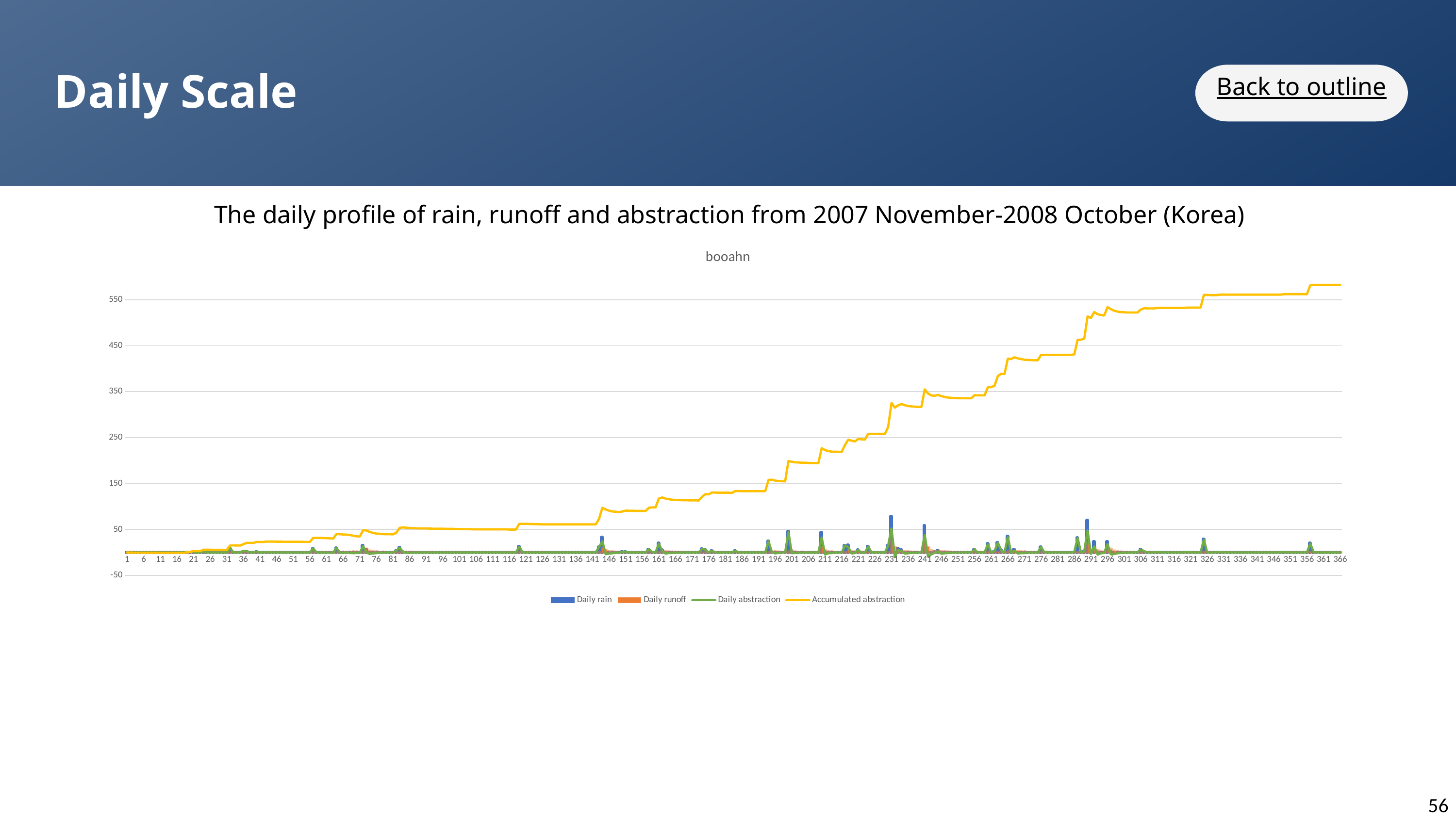
Which series has the highest value at day 366? Accumulated abstraction What are the series names listed in the legend? Daily rain, Daily runoff, Daily abstraction, Accumulated abstraction Does the Accumulated abstraction line rise or fall along the x axis? Rises Is the highest Daily rain bar (around day 231) greater or less than 50? greater How many series does the legend list? 4 What kind of chart is this? Combined bar and line chart Is the value of Accumulated abstraction at day 291 greater or less than 450? greater Is the value of Accumulated abstraction at day 146 greater or less than 150? less What is the title shown above the plot area of the chart? booahn